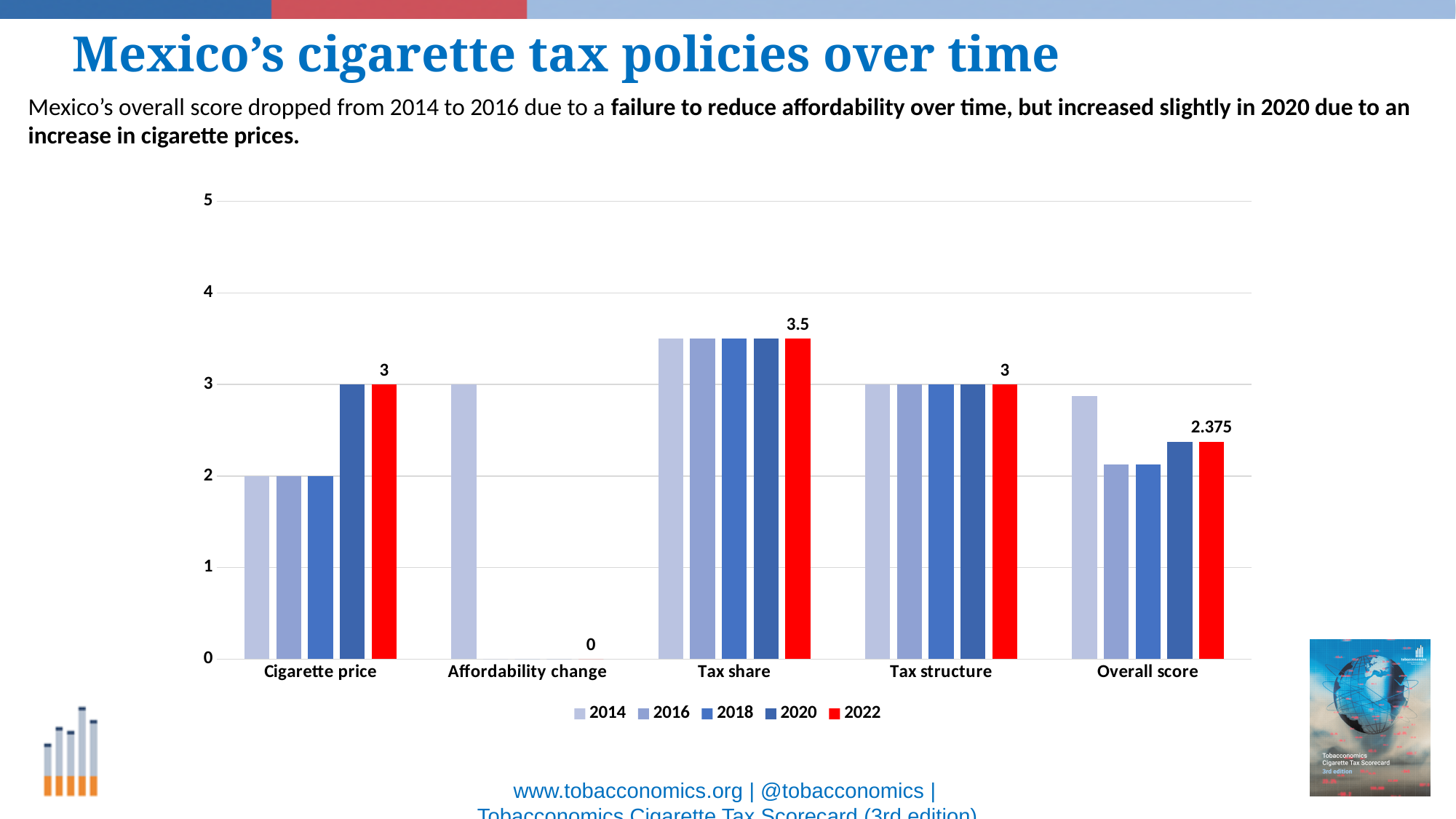
What is the 2014 value for Cigarette price? 2 What is the difference between the 2022 values for Tax share and Overall score? 1.125 Which category has the lowest 2022 value? Affordability change What is the 2022 value for Tax share? 3.5 What is the 2014 value for Affordability change? 3 Is the 2014 value for Overall score greater or less than 2? greater What is the 2022 value for Overall score? 2.375 How many categories are shown on the x axis? 5 What is the 2022 value for Affordability change? 0 Which category has the highest 2022 value? Tax share What type of chart is shown on the slide? bar chart How many series does the legend list? 5